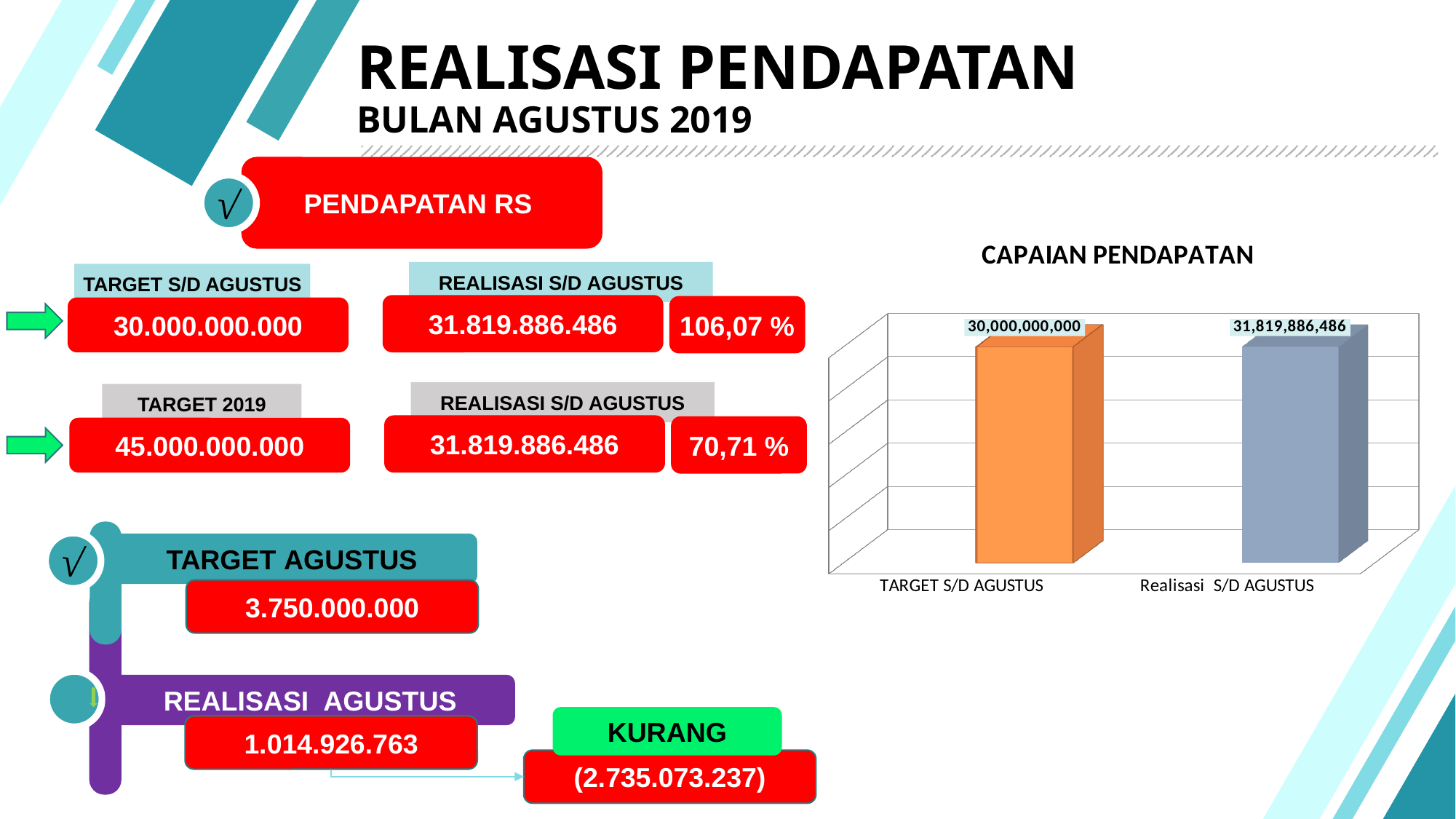
In the CAPAIAN PENDAPATAN chart, which is larger: TARGET S/D AGUSTUS or Realisasi S/D AGUSTUS? Realisasi S/D AGUSTUS What kind of chart is the CAPAIAN PENDAPATAN chart? Bar chart Do the values in the CAPAIAN PENDAPATAN chart rise or fall from left to right? Rise What colour is the TARGET S/D AGUSTUS bar in the CAPAIAN PENDAPATAN chart? Orange Which category has the lowest value in the CAPAIAN PENDAPATAN chart? TARGET S/D AGUSTUS What is the value for TARGET S/D AGUSTUS in the CAPAIAN PENDAPATAN chart? 30,000,000,000 What is the value for Realisasi S/D AGUSTUS in the CAPAIAN PENDAPATAN chart? 31,819,886,486 Which category has the highest value in the CAPAIAN PENDAPATAN chart? Realisasi S/D AGUSTUS What is the difference between the Realisasi S/D AGUSTUS value and the TARGET S/D AGUSTUS value in the CAPAIAN PENDAPATAN chart? 1,819,886,486 What is the title of the chart on the slide? CAPAIAN PENDAPATAN How many bars are plotted in the CAPAIAN PENDAPATAN chart? 2